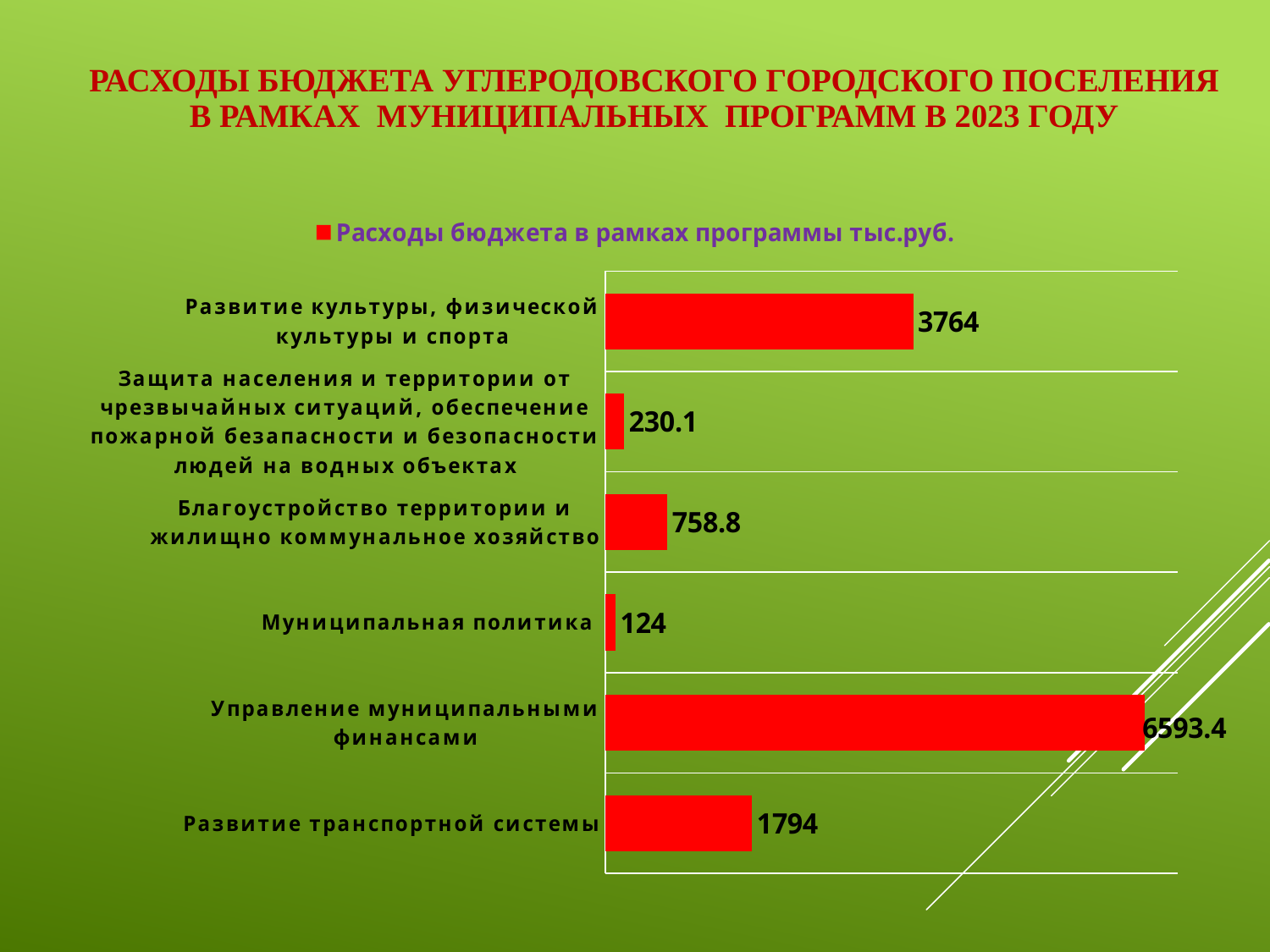
What is the value for Развитие транспортной системы? 1794 What is the difference between the values for Развитие культуры, физической культуры и спорта and Развитие транспортной системы? 1970 What is the legend entry of the series shown in the chart? Расходы бюджета в рамках программы тыс.руб. How many categories are shown in the chart? 6 What kind of chart is shown on the slide? Bar chart Which category has the lowest value? Муниципальная политика What is the value for Муниципальная политика? 124 What is the difference between the values for Благоустройство территории и жилищно коммунальное хозяйство and Защита населения и территории от чрезвычайных ситуаций, обеспечение пожарной безапасности и безопасности людей на водных объектах? 528.7 Which is larger: the value for Развитие культуры, физической культуры и спорта or the value for Развитие транспортной системы? Развитие культуры, физической культуры и спорта What is the value for Благоустройство территории и жилищно коммунальное хозяйство? 758.8 What is the value for Управление муниципальными финансами? 6593.4 Which category has the highest value? Управление муниципальными финансами